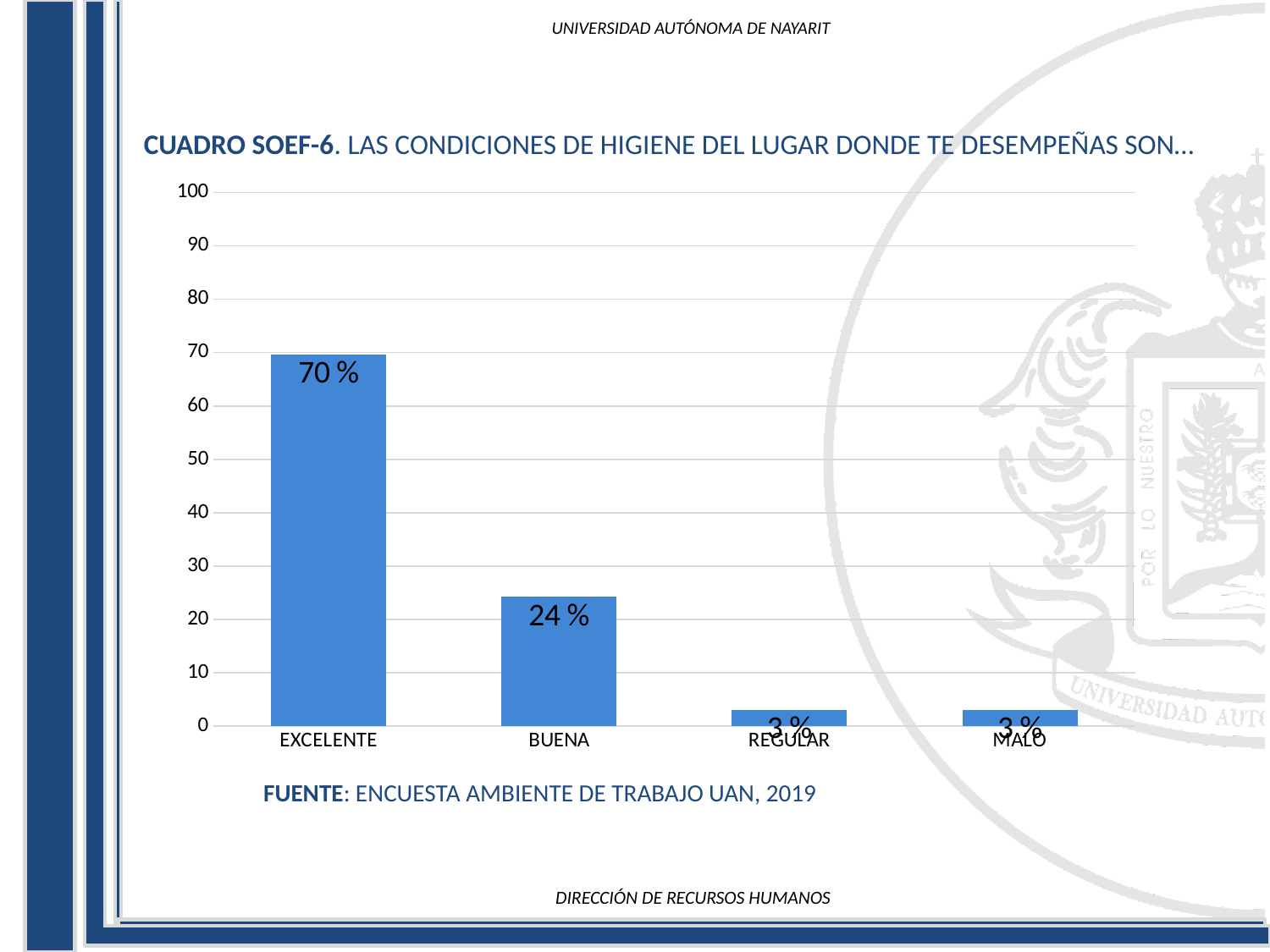
What source is cited below the chart? ENCUESTA AMBIENTE DE TRABAJO UAN, 2019 Is the value for EXCELENTE greater or less than 60? greater Which is larger, the value for BUENA or the value for REGULAR? BUENA Which category has the highest value? EXCELENTE What value is shown for EXCELENTE? 70 % How many categories are shown on the x axis? 4 What is the difference between the values for EXCELENTE and BUENA? 46 % Is the value for BUENA greater or less than 30? less What kind of chart is shown on the slide? bar chart What value is shown for BUENA? 24 % What value is shown for MALO? 3 % What value is shown for REGULAR? 3 %